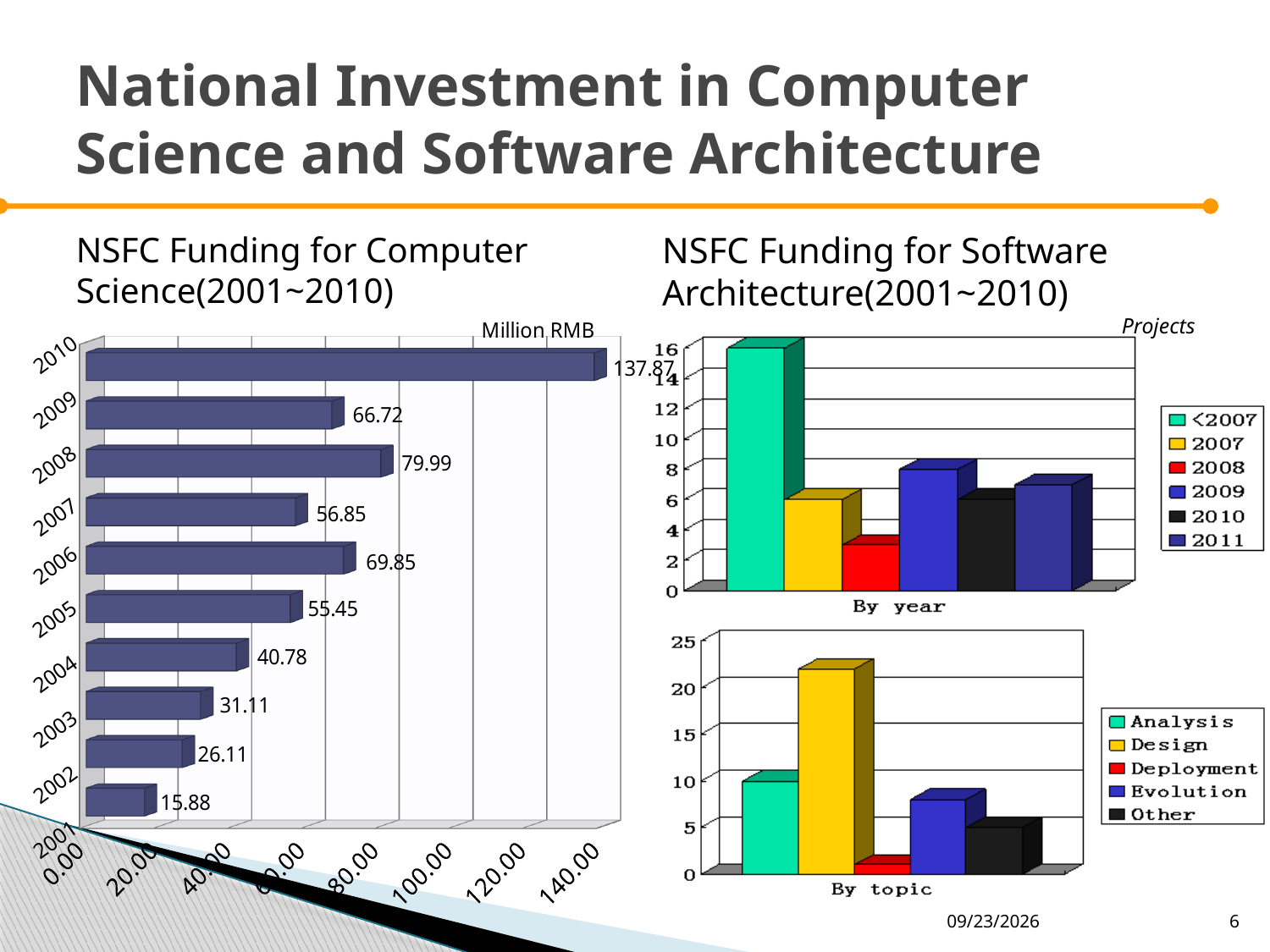
How many entries does the legend of the 'By topic' chart list? 5 What unit is shown above the NSFC Funding for Computer Science chart? Million RMB In the 'By year' chart on the right, which category has the lowest value? 2008 In the 'By topic' chart, which topic has the highest value? Design In the NSFC Funding for Computer Science chart, what is the value for 2005? 55.45 In the NSFC Funding for Computer Science chart, which year has the lowest value? 2001 In the NSFC Funding for Computer Science chart, what is the value for 2010? 137.87 How many years are shown in the NSFC Funding for Computer Science chart? 10 In the 'By year' chart on the right, is the value for <2007 greater or less than 14? greater In the NSFC Funding for Computer Science chart, which year has the highest value? 2010 In the NSFC Funding for Computer Science chart, which is larger, the value for 2006 or the value for 2007? 2006 In the NSFC Funding for Computer Science chart, what is the difference between the values for 2008 and 2009? 13.27